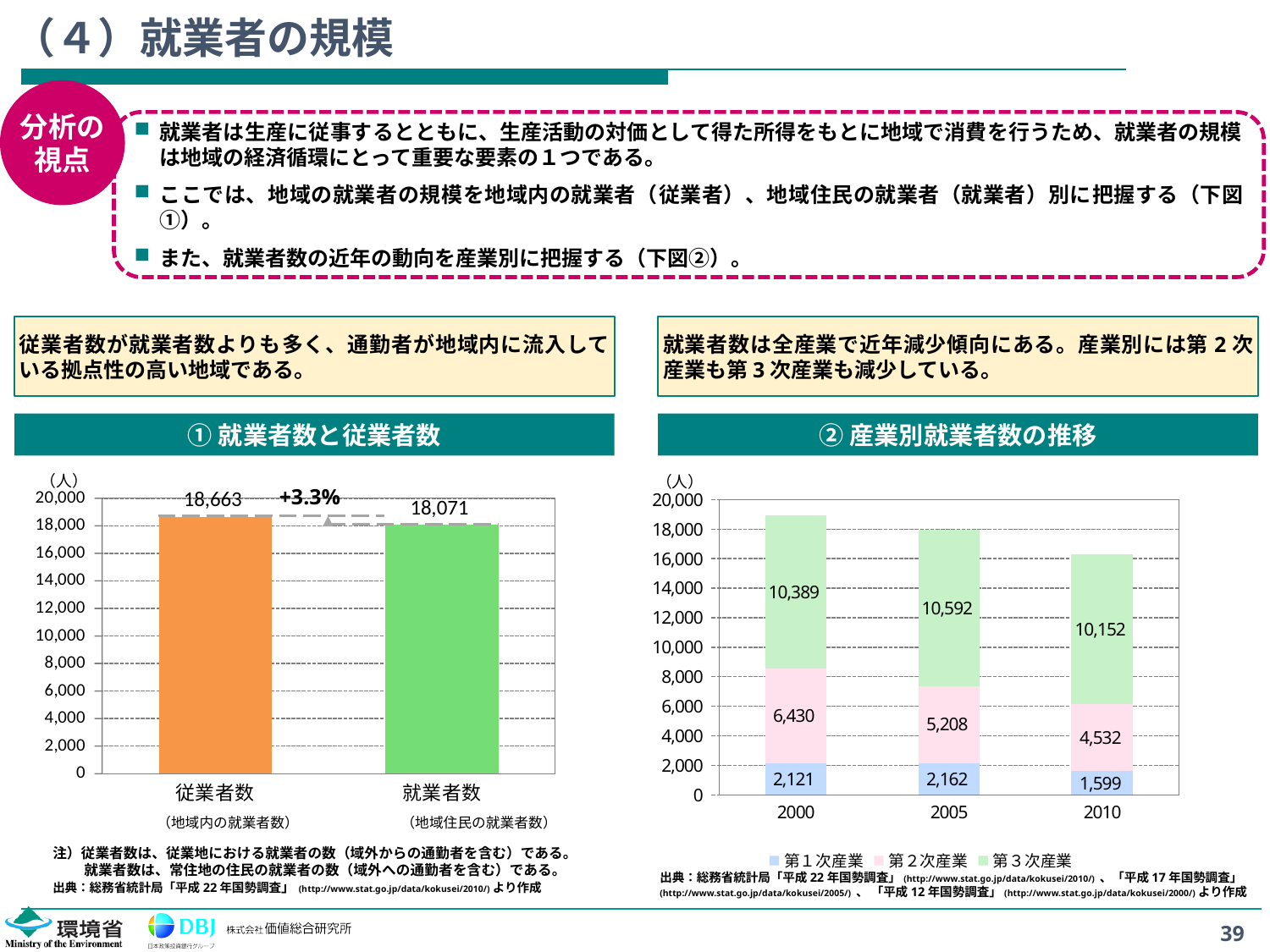
In chart ② 産業別就業者数の推移, what is the value for 第１次産業 in 2010? 1,599 In chart ② 産業別就業者数の推移, which year has the lowest value for 第２次産業? 2010 In chart ① 就業者数と従業者数, what is the difference between 従業者数 and 就業者数? 592 In chart ① 就業者数と従業者数, which is larger, 従業者数 or 就業者数? 従業者数 In chart ① 就業者数と従業者数, what is the value for 従業者数? 18,663 In chart ① 就業者数と従業者数, what percentage is printed above the bars? +3.3% In chart ② 産業別就業者数の推移, what is the value for 第２次産業 in 2000? 6,430 In chart ② 産業別就業者数の推移, how many series does the legend list? 3 In chart ② 産業別就業者数の推移, what is the total of the stacked bar for 2010? 16,283 What kind of chart is chart ② 産業別就業者数の推移? Stacked bar chart In chart ② 産業別就業者数の推移, what is the value for 第３次産業 in 2005? 10,592 In chart ① 就業者数と従業者数, what is the value for 就業者数? 18,071